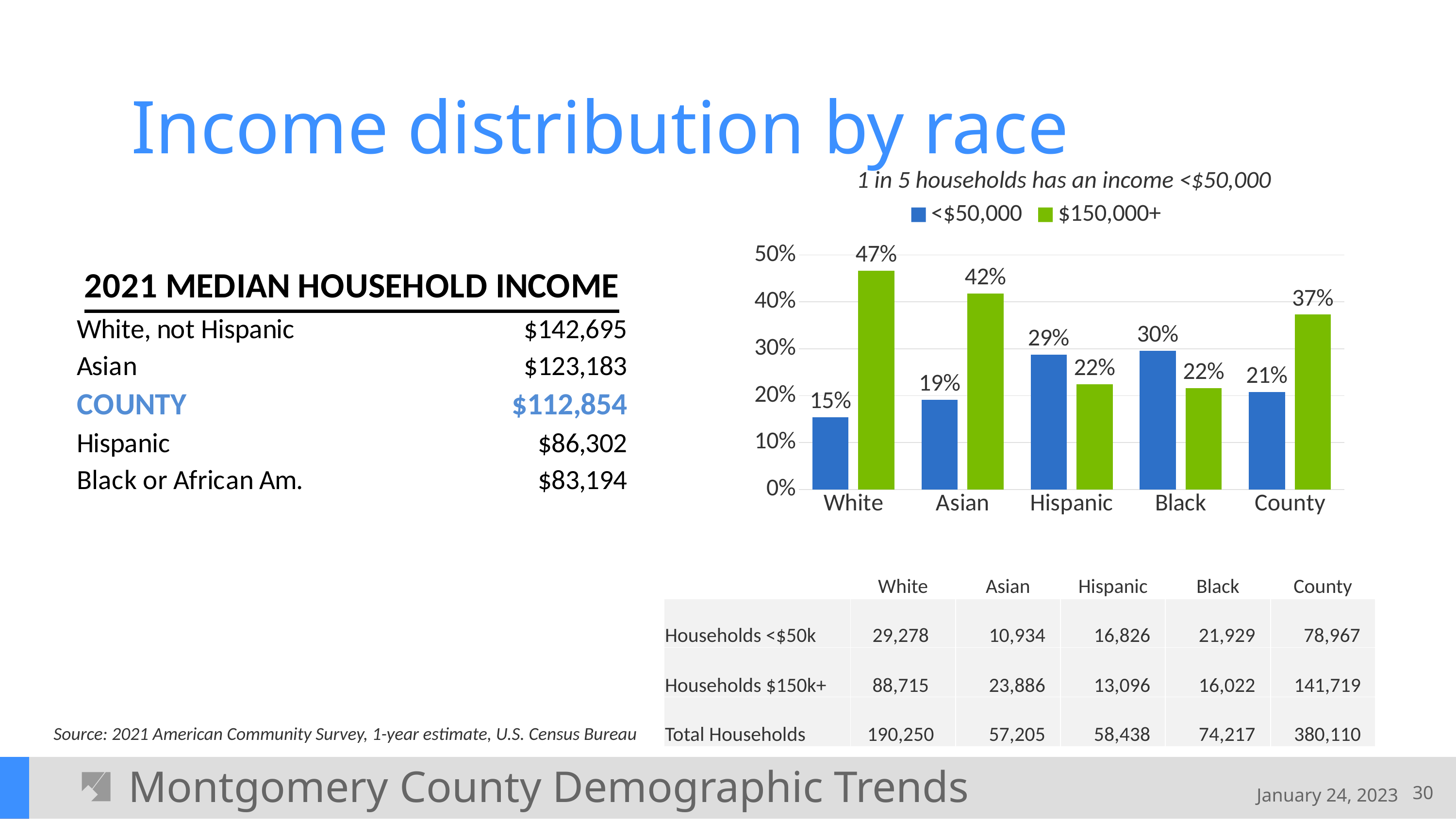
What colour represents the $150,000+ series in the chart? green What is the value for County in the $150,000+ series? 37% How many categories are shown on the x axis of the chart? 5 What kind of chart is shown on the slide? bar chart Which category has the lowest value in the <$50,000 series? White Which is larger for Hispanic: the <$50,000 value or the $150,000+ value? <$50,000 How many series does the chart legend list? 2 What is the value for White in the <$50,000 series? 15% Is the value for Black in the <$50,000 series greater or less than 20%? greater What is the value for Asian in the $150,000+ series? 42% Which category has the highest value in the $150,000+ series? White What is the difference between the $150,000+ and <$50,000 values for White? 32%